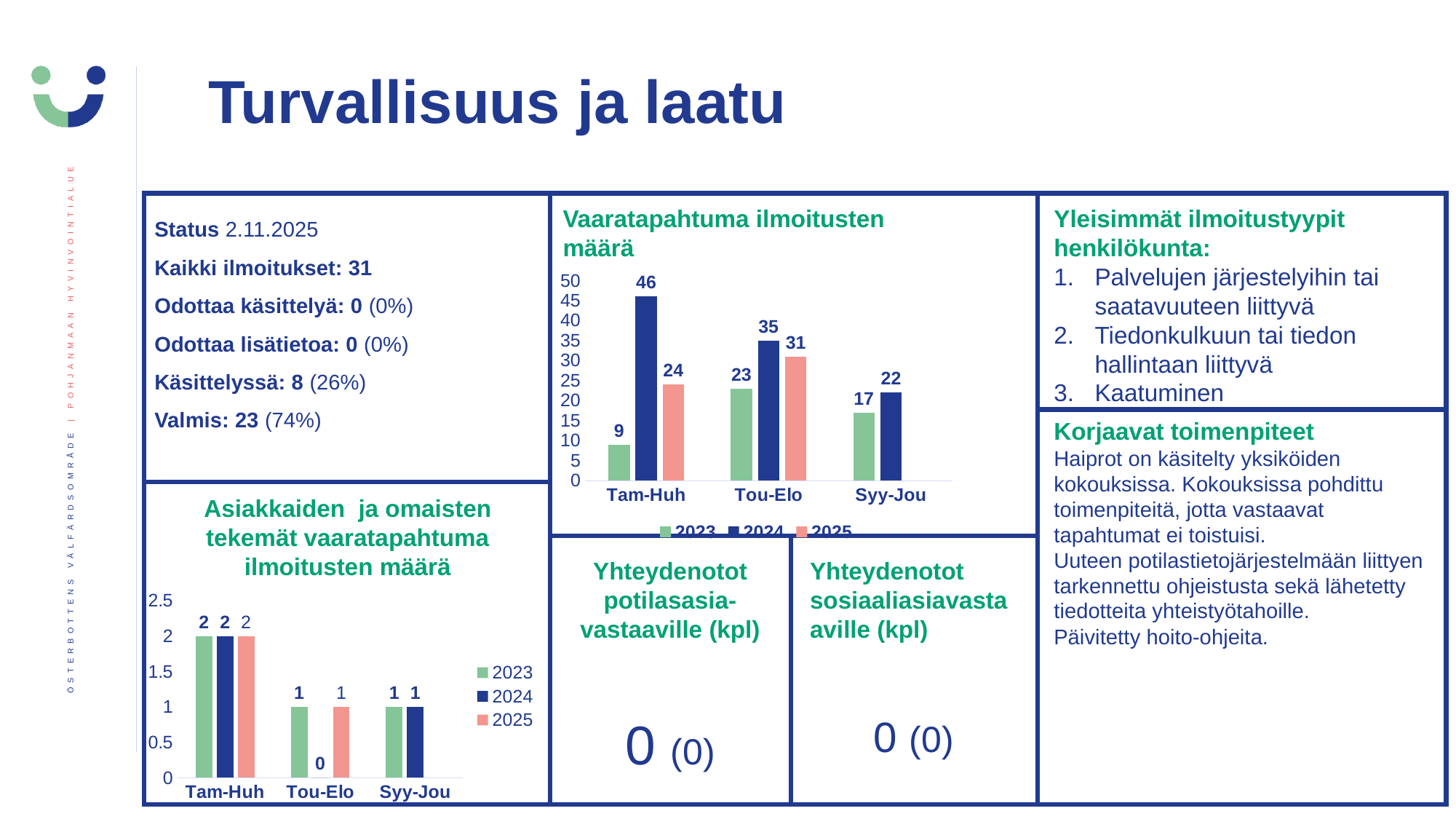
In the 'Vaaratapahtuma ilmoitusten määrä' chart, what is the difference between the 2024 and 2023 values in Tam-Huh? 37 In the 'Asiakkaiden ja omaisten tekemät vaaratapahtuma ilmoitusten määrä' chart, what is the value for 2024 in Tou-Elo? 0 In the 'Asiakkaiden ja omaisten tekemät vaaratapahtuma ilmoitusten määrä' chart, how many periods are shown on the x axis? 3 In the 'Vaaratapahtuma ilmoitusten määrä' chart, how many series does the legend list? 3 In the 'Vaaratapahtuma ilmoitusten määrä' chart, which period has the highest 2024 value? Tam-Huh In the 'Vaaratapahtuma ilmoitusten määrä' chart, what is the value for 2024 in Tam-Huh? 46 In the 'Vaaratapahtuma ilmoitusten määrä' chart, what is the value for 2023 in Syy-Jou? 17 In the 'Vaaratapahtuma ilmoitusten määrä' chart, what is the value for 2025 in Tou-Elo? 31 What kind of chart is the 'Asiakkaiden ja omaisten tekemät vaaratapahtuma ilmoitusten määrä' chart? Bar chart In the 'Vaaratapahtuma ilmoitusten määrä' chart, how do the 2023 values change from Tam-Huh to Tou-Elo? They rise In the 'Vaaratapahtuma ilmoitusten määrä' chart, which is larger in Tou-Elo: the 2024 value or the 2025 value? 2024 In the 'Vaaratapahtuma ilmoitusten määrä' chart, which period has the lowest 2023 value? Tam-Huh